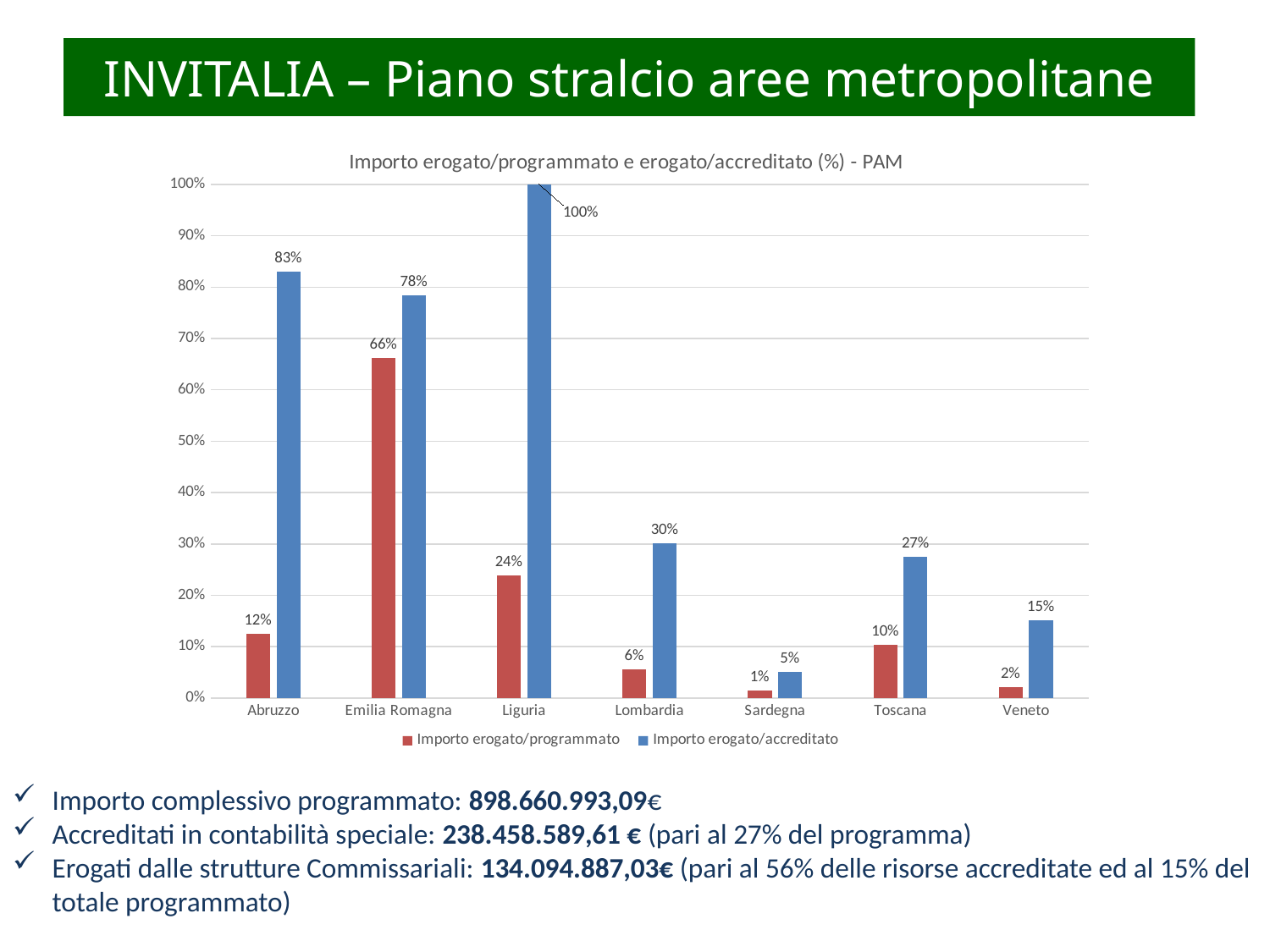
How many regions are shown on the x axis of the chart? 7 What is the value of Importo erogato/programmato for Emilia Romagna? 66% Which region has the highest value for Importo erogato/programmato? Emilia Romagna How many series does the chart legend list? 2 Which region has the lowest value for Importo erogato/accreditato? Sardegna What kind of chart is shown on the slide? Bar chart What is the title of the chart? Importo erogato/programmato e erogato/accreditato (%) - PAM What is the difference between Importo erogato/accreditato and Importo erogato/programmato for Lombardia? 24% Which is larger: Importo erogato/accreditato for Toscana or for Veneto? Toscana What is the value of Importo erogato/programmato for Toscana? 10% What is the value of Importo erogato/accreditato for Liguria? 100% What is the value of Importo erogato/accreditato for Abruzzo? 83%